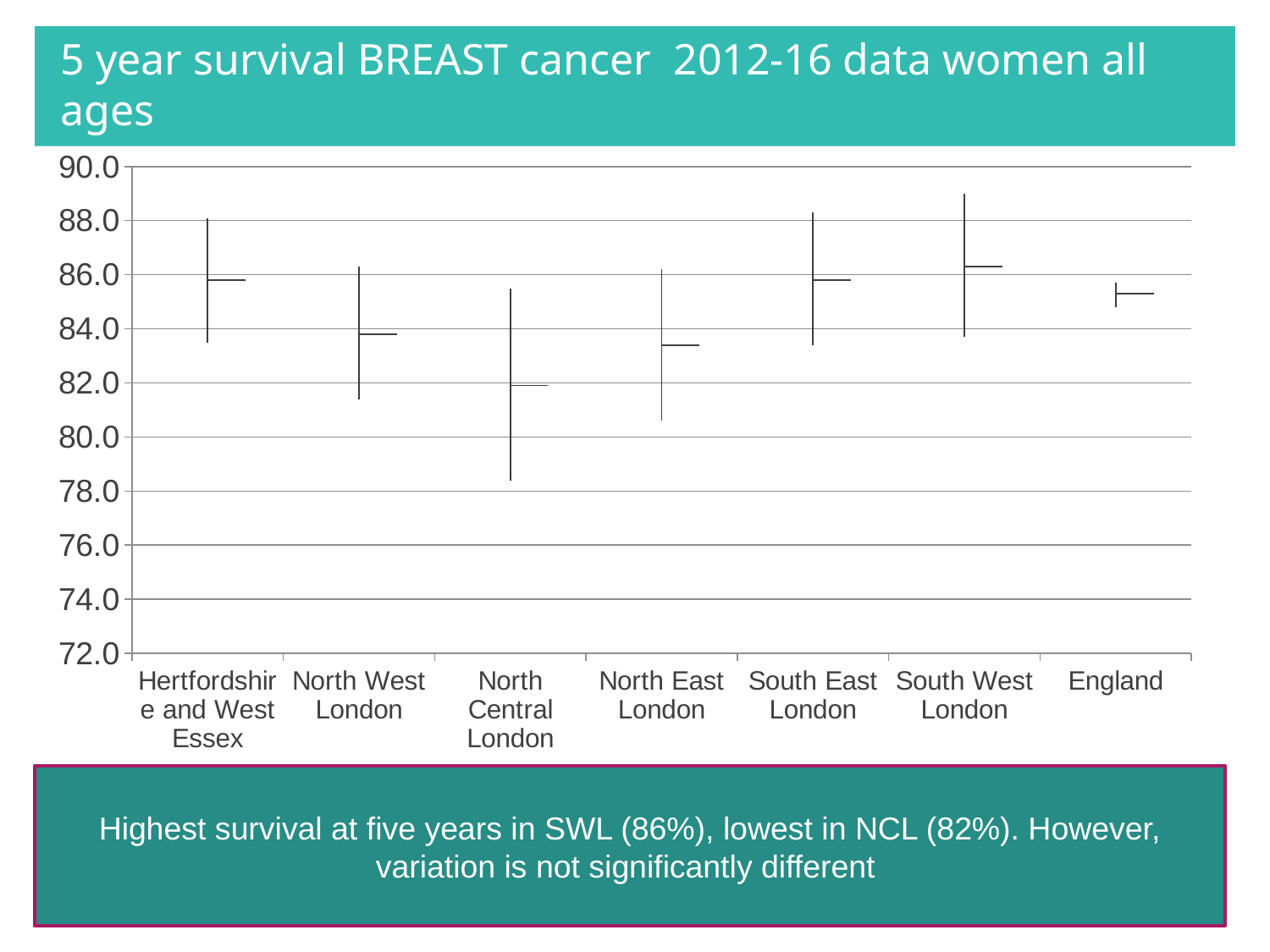
Which area has the highest 5 year survival point estimate? South West London Which has the higher survival point estimate, Hertfordshire and West Essex or North West London? Hertfordshire and West Essex Is the survival point estimate for North Central London greater or less than 84.0? less What is the title of the slide containing the chart? 5 year survival BREAST cancer 2012-16 data women all ages Which area has the lowest 5 year survival point estimate? North Central London How many areas are shown on the x axis of the chart? 7 Is the survival point estimate for South West London greater or less than 84.0? greater Is the survival point estimate for North East London greater or less than 86.0? less Which has the higher survival point estimate, North Central London or North East London? North East London According to the text box below the chart, what is the five year survival in SWL? 86%